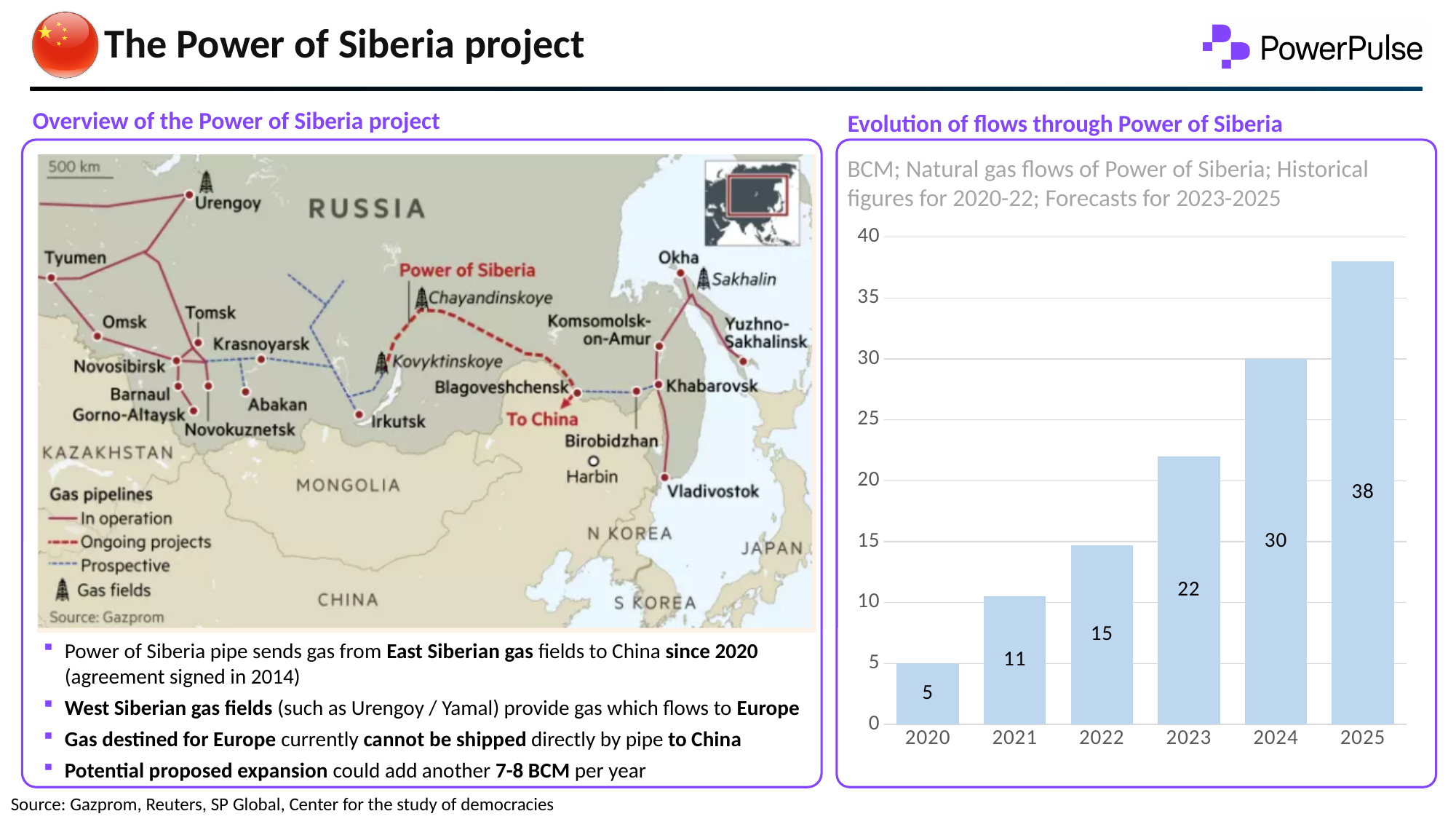
In the 'Evolution of flows through Power of Siberia' chart, what is the difference between the values for 2025 and 2020? 33 In the 'Evolution of flows through Power of Siberia' chart, what is the difference between the values for 2023 and 2022? 7 In the 'Evolution of flows through Power of Siberia' chart, is the value for 2025 greater or less than 35? greater In the 'Evolution of flows through Power of Siberia' chart, what is the value for 2024? 30 In the 'Evolution of flows through Power of Siberia' chart, which year has the highest value? 2025 In the 'Evolution of flows through Power of Siberia' chart, do the values rise or fall from 2020 to 2025? rise In the 'Evolution of flows through Power of Siberia' chart, which is larger, the value for 2021 or the value for 2023? 2023 What kind of chart is 'Evolution of flows through Power of Siberia'? bar chart In the 'Evolution of flows through Power of Siberia' chart, which year has the lowest value? 2020 What unit is used for the values in the 'Evolution of flows through Power of Siberia' chart? BCM In the 'Evolution of flows through Power of Siberia' chart, what is the value for 2022? 15 How many years are shown on the x axis of the 'Evolution of flows through Power of Siberia' chart? 6